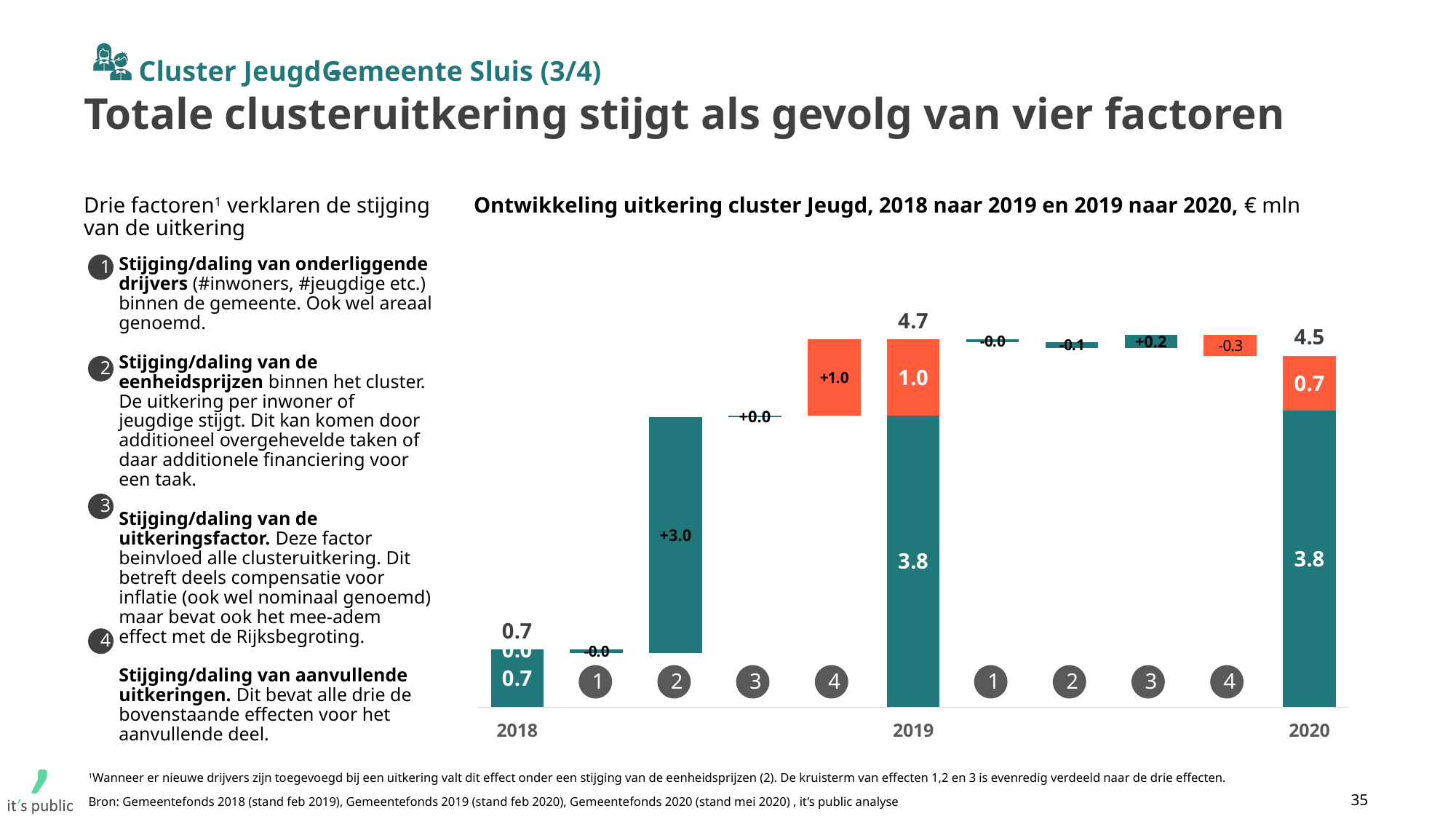
What is the total uitkering for cluster Jeugd in 2018 shown above the bar? 0.7 What is the value of the step for factor 2 between 2018 and 2019? +3.0 What is the value of the step for factor 4 between 2018 and 2019? +1.0 What is the value of the teal (lower) segment of the 2020 bar? 3.8 Which factor has the largest step between 2018 and 2019? Factor 2 (+3.0) What is the total uitkering for cluster Jeugd in 2020 shown above the bar? 4.5 What is the value of the step for factor 4 between 2019 and 2020? -0.3 Which year has the highest total uitkering in the chart? 2019 What is the total uitkering for cluster Jeugd in 2019 shown above the bar? 4.7 What is the difference between the 2019 total (4.7) and the 2020 total (4.5)? 0.2 What kind of chart is shown on the slide? Bar chart (waterfall) What is the value of the step for factor 3 between 2019 and 2020? +0.2